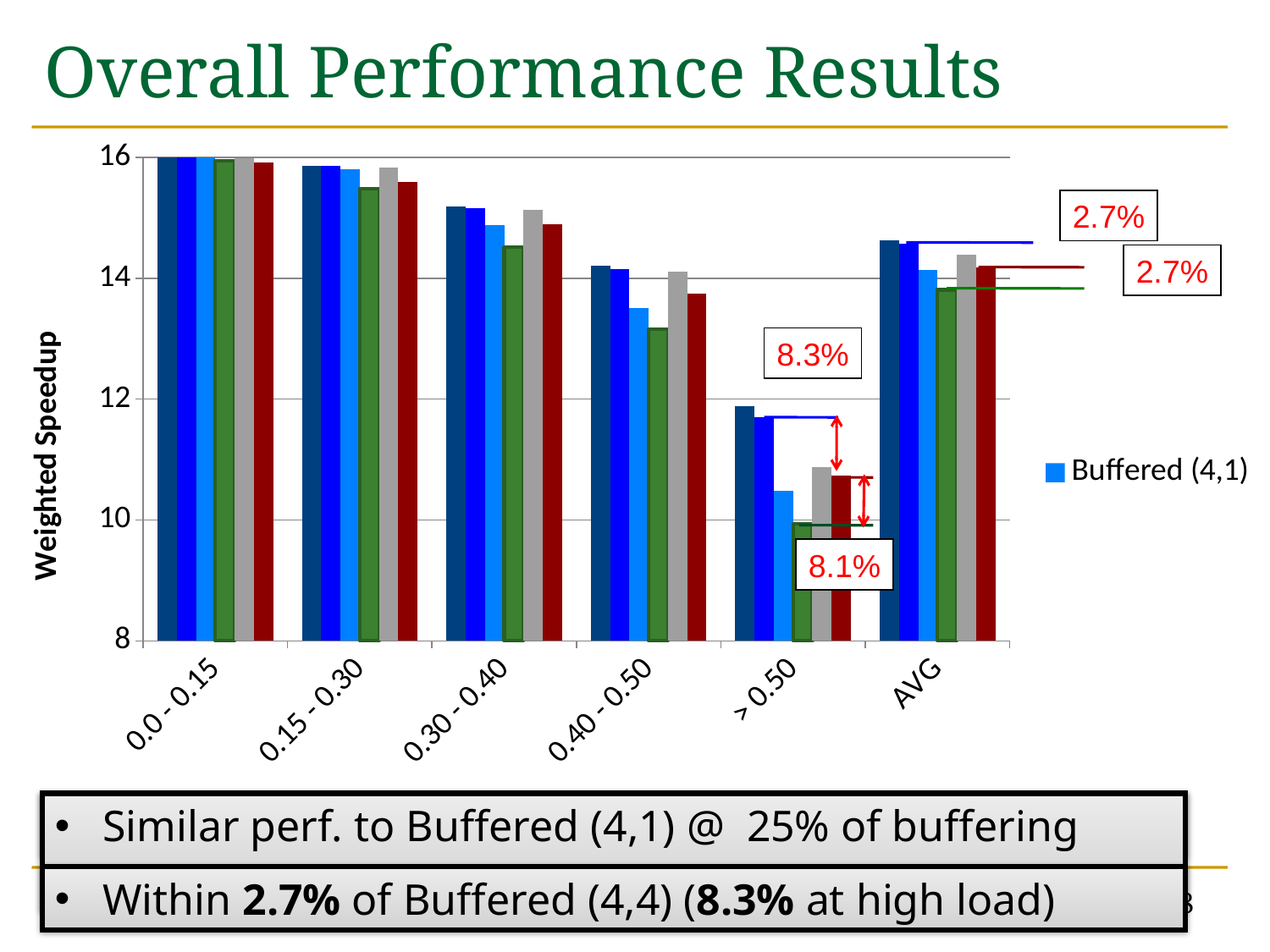
Is the Buffered (4,1) value for '0.40 - 0.50' greater or less than 14? less Which category has the lowest bars in the chart? > 0.50 Do the weighted speedup values rise or fall from the '0.0 - 0.15' category to the '> 0.50' category? fall What kind of chart is shown on the slide? bar chart Which series name is readable in the chart's legend? Buffered (4,1) How many bars are plotted for each category in the chart? 6 Is the Buffered (4,1) value for '> 0.50' greater or less than 12? less What percentage difference is annotated below the '> 0.50' group in the chart? 8.1% What is the title of the y axis of the chart? Weighted Speedup How many categories are shown on the x axis of the chart? 6 Which category has the highest bars in the chart? 0.0 - 0.15 What percentage difference is annotated above the '> 0.50' group in the chart? 8.3%